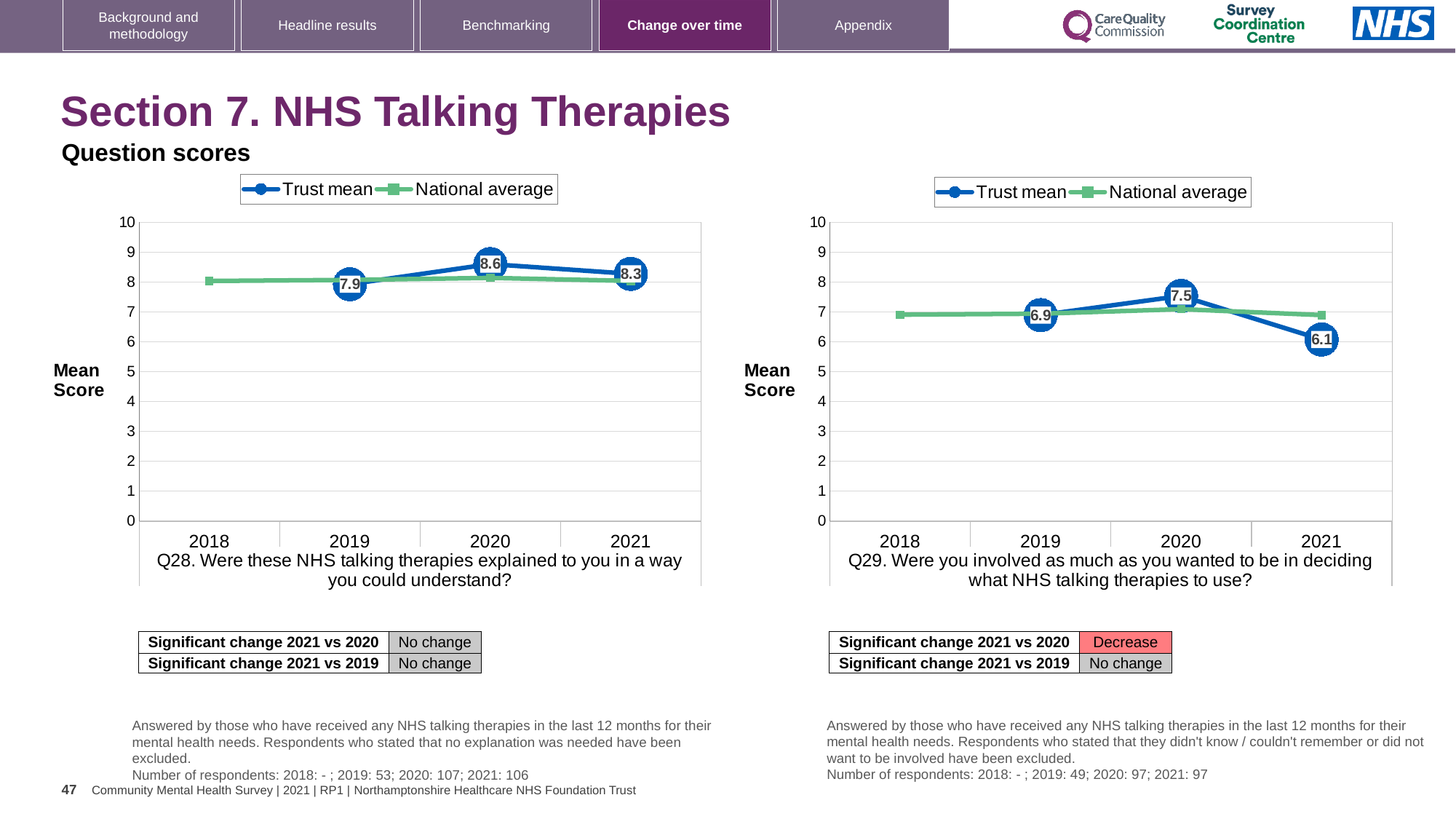
In the Q28 chart on the left, what is the Trust mean for 2019? 7.9 In the Q29 chart on the right, what is the Trust mean for 2020? 7.5 In the Q29 chart on the right, is the National average for 2018 greater or less than 8? less In the Q29 chart on the right, does the Trust mean rise or fall from 2020 to 2021? fall In the Q29 chart on the right, which year has the lowest Trust mean? 2021 In the Q29 chart on the right, what is the difference between the Trust mean for 2020 and the Trust mean for 2021? 1.4 What kind of chart is the Q29 chart on the right? line chart In the Q28 chart on the left, which year has the highest Trust mean? 2020 How many series does the legend of the Q28 chart on the left list? 2 In the Q29 chart on the right, what is the Trust mean for 2021? 6.1 In the Q28 chart on the left, which is larger: the Trust mean for 2021 or the Trust mean for 2019? 2021 In the Q28 chart on the left, what is the Trust mean for 2020? 8.6